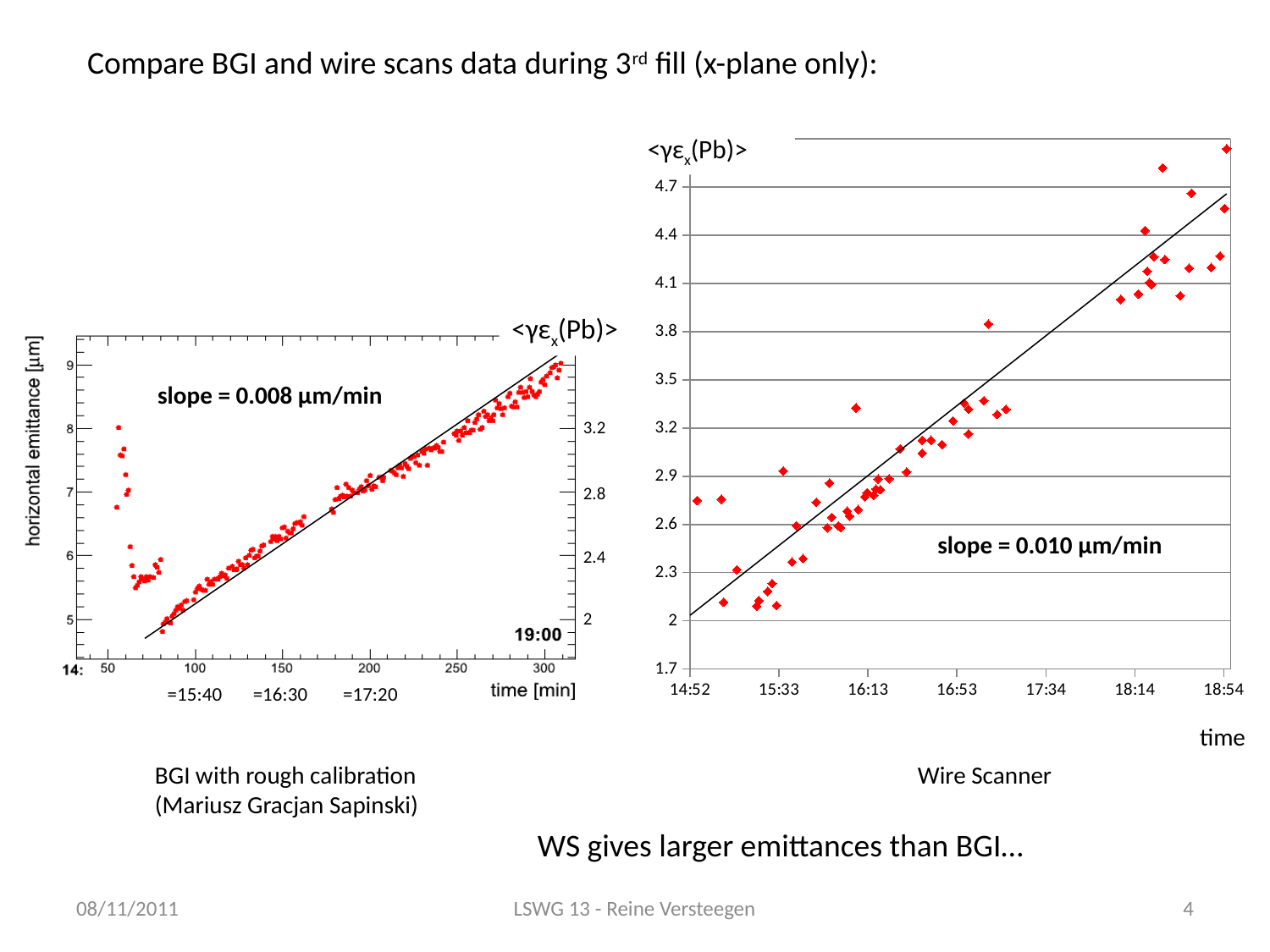
What colour are the data markers on the Wire Scanner chart? red What kind of chart is the Wire Scanner chart on the right? scatter chart On the Wire Scanner chart, is the first data point at 14:52 greater or less than 2.6? greater On the BGI chart, do the values rise or fall as time goes from 100 min to 300 min? rise On the BGI chart, are the data points near 300 min greater or less than 8 on the left axis? greater On the Wire Scanner chart on the right, what slope is printed on the chart? 0.010 μm/min Which chart shows the larger printed slope, the BGI chart or the Wire Scanner chart? Wire Scanner On the Wire Scanner chart, do the emittance values rise or fall as time goes from 14:52 to 18:54? rise On the Wire Scanner chart, is the highest data point near 18:54 greater or less than 4.7? greater On the BGI chart on the left, what slope is printed on the chart? 0.008 μm/min What is the label of the vertical axis on the BGI chart? horizontal emittance [μm]